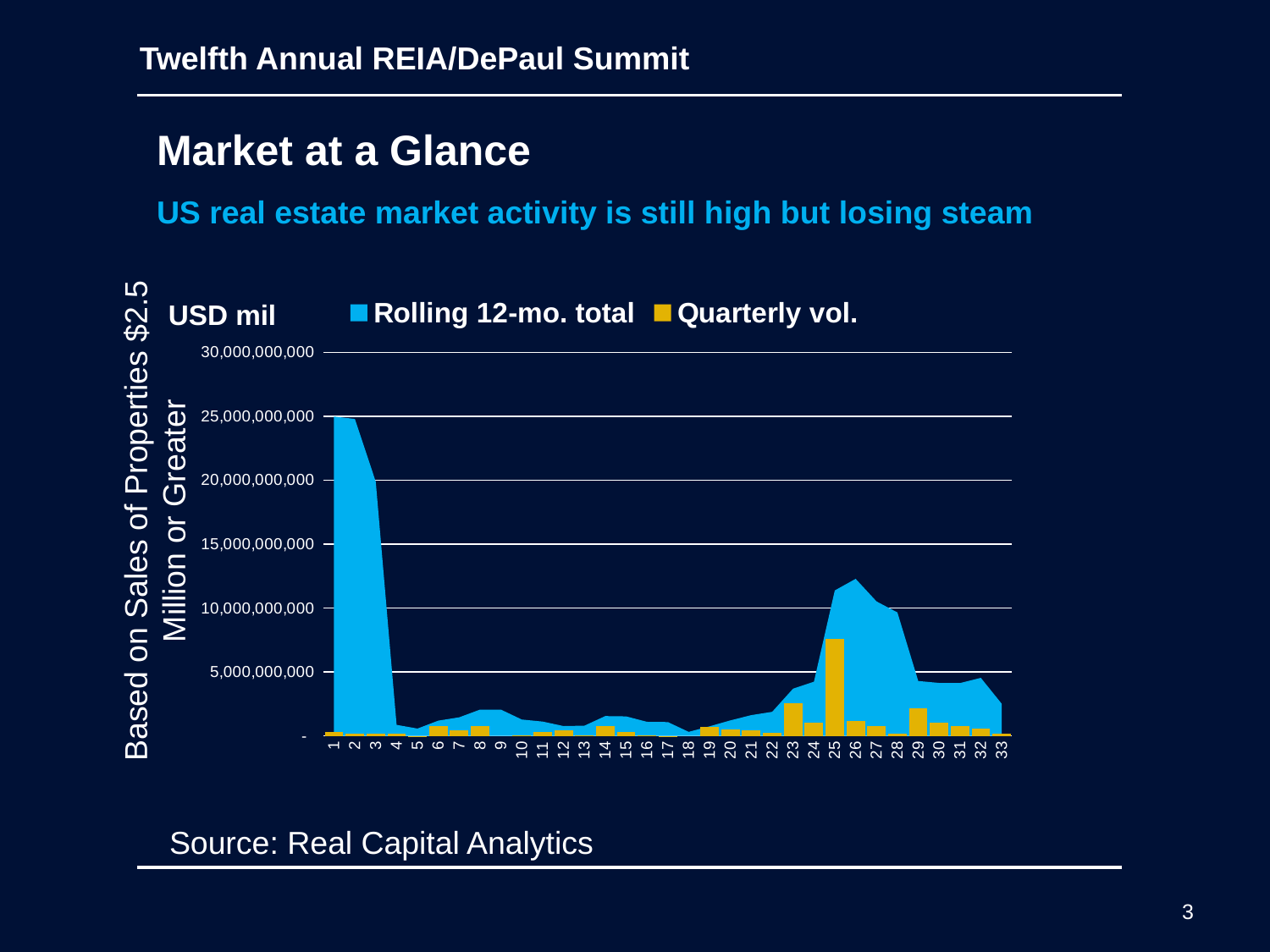
How many points are shown along the x axis of the chart? 33 Overall, does the Rolling 12-mo. total rise or fall from point 1 to point 33? Fall How many series does the chart legend list? 2 Which is larger, the Quarterly vol. at point 25 or at point 23? Point 25 Is the Rolling 12-mo. total at point 26 greater or less than 10,000,000,000? greater Is the Rolling 12-mo. total at point 10 greater or less than 5,000,000,000? less What kind of chart is shown on the slide? A combination of an area chart and a bar chart Is the Quarterly vol. at point 25 greater or less than 5,000,000,000? greater What are the two series named in the chart legend? Rolling 12-mo. total and Quarterly vol. At which x-axis point is the Rolling 12-mo. total highest? 1 Which is larger, the Rolling 12-mo. total at point 2 or at point 26? Point 2 At which x-axis point is the Quarterly vol. highest? 25